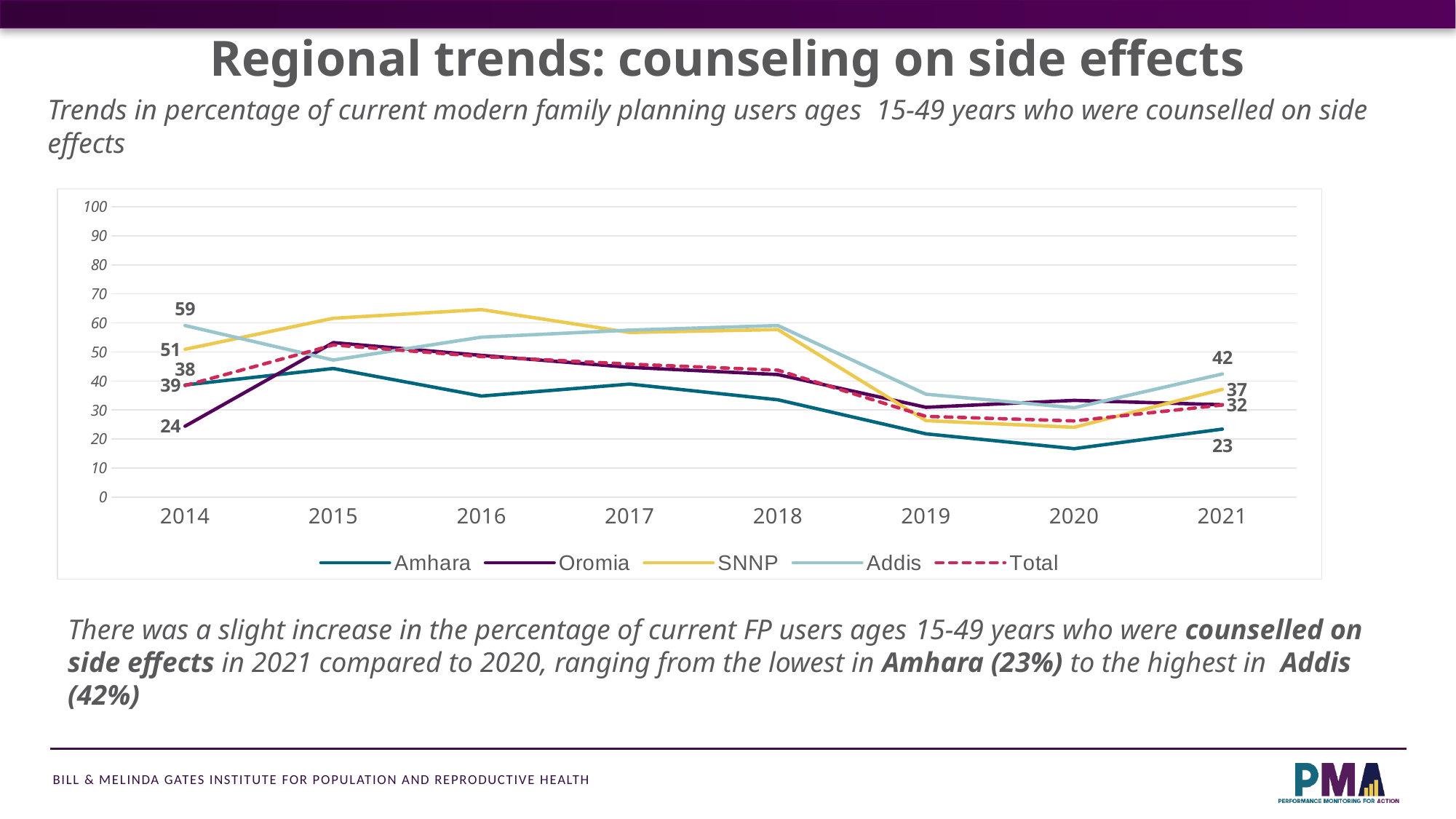
What is the value for Oromia in 2014? 24 What is the value for SNNP in 2021? 37 Which series is drawn with a dashed line? Total Which region has the lowest value in 2014? Oromia What is the difference between the Addis value in 2014 and its value in 2021? 17 What is the value for Amhara in 2021? 23 Is the value for SNNP in 2016 greater or less than 60? greater How many series does the legend list? 5 What is the value for Addis in 2014? 59 What type of chart is shown on the slide? Line chart Which region has the highest value in 2021? Addis How many years are shown on the x axis? 8